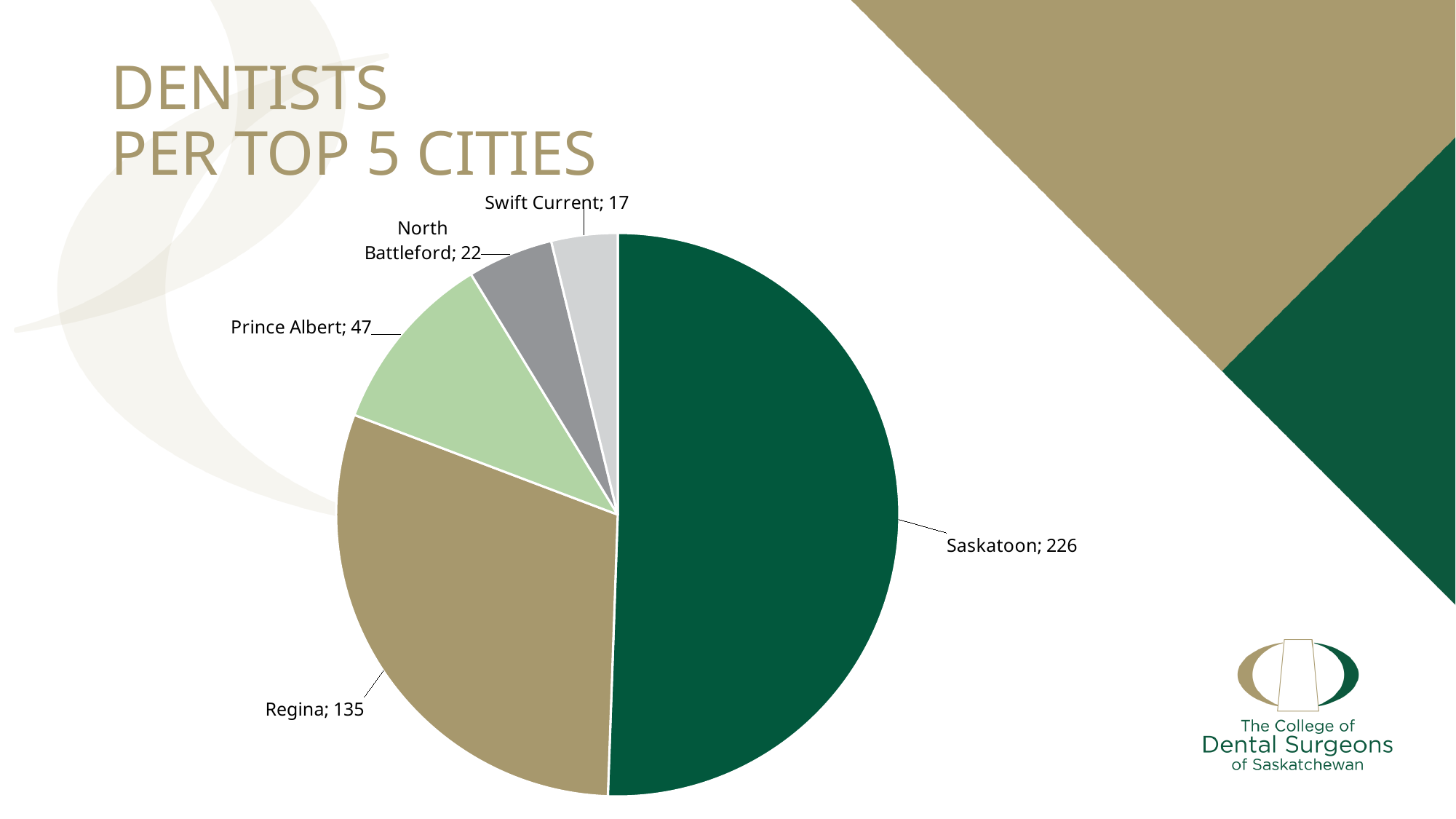
Which has more dentists, North Battleford or Swift Current? North Battleford What is the value shown for Regina in the pie chart? 135 How many cities are shown in the pie chart? 5 What is the title of the slide? DENTISTS PER TOP 5 CITIES How many dentists are shown for Prince Albert? 47 What is the difference between the number of dentists in Saskatoon and in Regina? 91 What type of chart is shown on the slide? Pie chart What value is labelled for North Battleford? 22 How many more dentists does Prince Albert have than North Battleford? 25 How many dentists does the pie chart show for Saskatoon? 226 Which city has the largest slice of the pie chart? Saskatoon Which city has the smallest slice of the pie chart? Swift Current